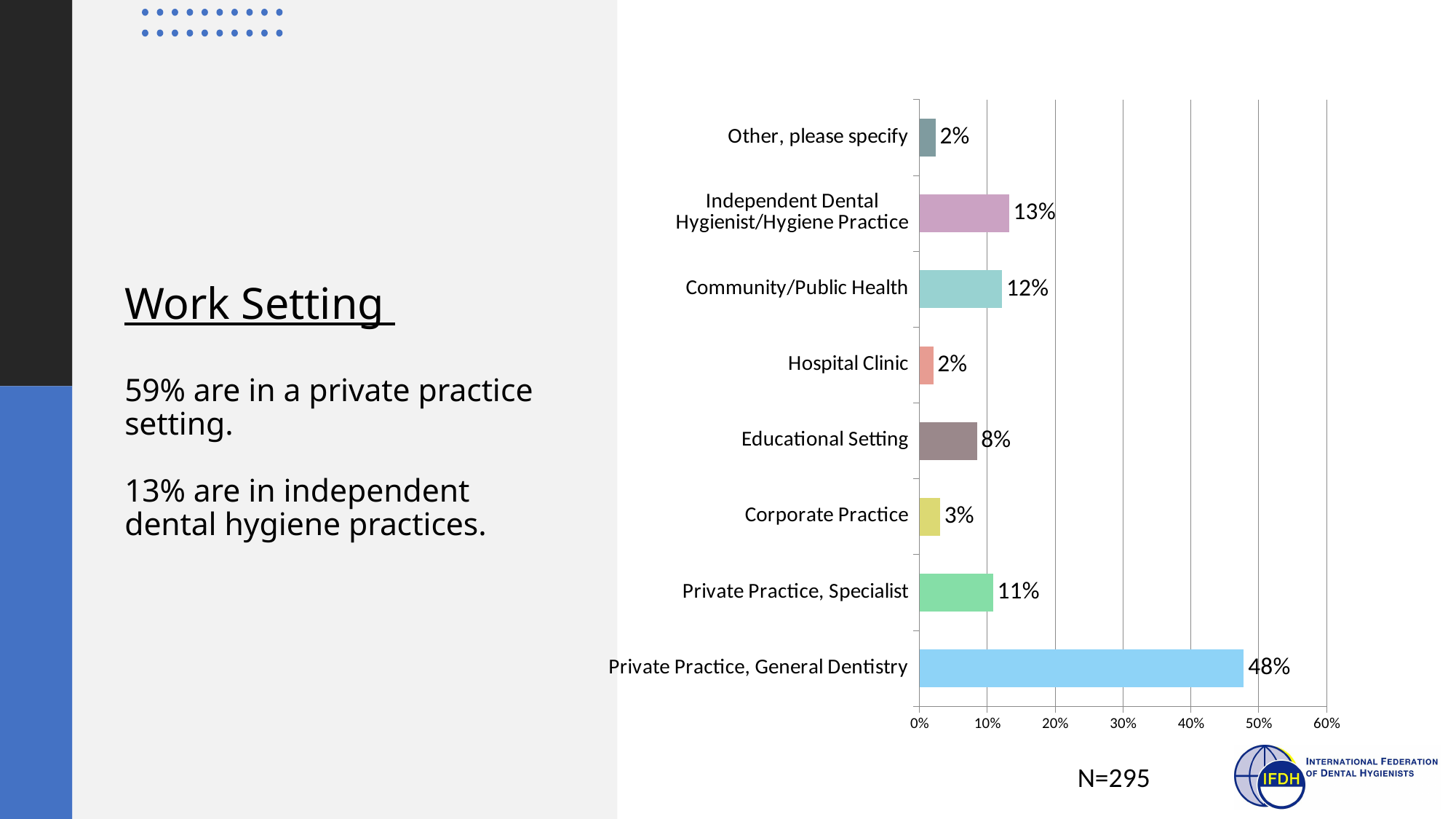
What type of chart is shown on the slide? Bar chart Is the value for Private Practice, General Dentistry greater or less than 40%? greater How many work setting categories are shown in the chart? 8 What is the value shown for Community/Public Health? 12% What percentage of respondents work in Private Practice, General Dentistry? 48% What is the difference between Private Practice, General Dentistry and Private Practice, Specialist? 37% What is the difference between Independent Dental Hygienist/Hygiene Practice and Community/Public Health? 1% What percentage is shown for Educational Setting? 8% Which work setting has the highest percentage? Private Practice, General Dentistry What is the value for Independent Dental Hygienist/Hygiene Practice? 13% Which is larger, Educational Setting or Corporate Practice? Educational Setting What is the sample size (N) noted below the chart? N=295